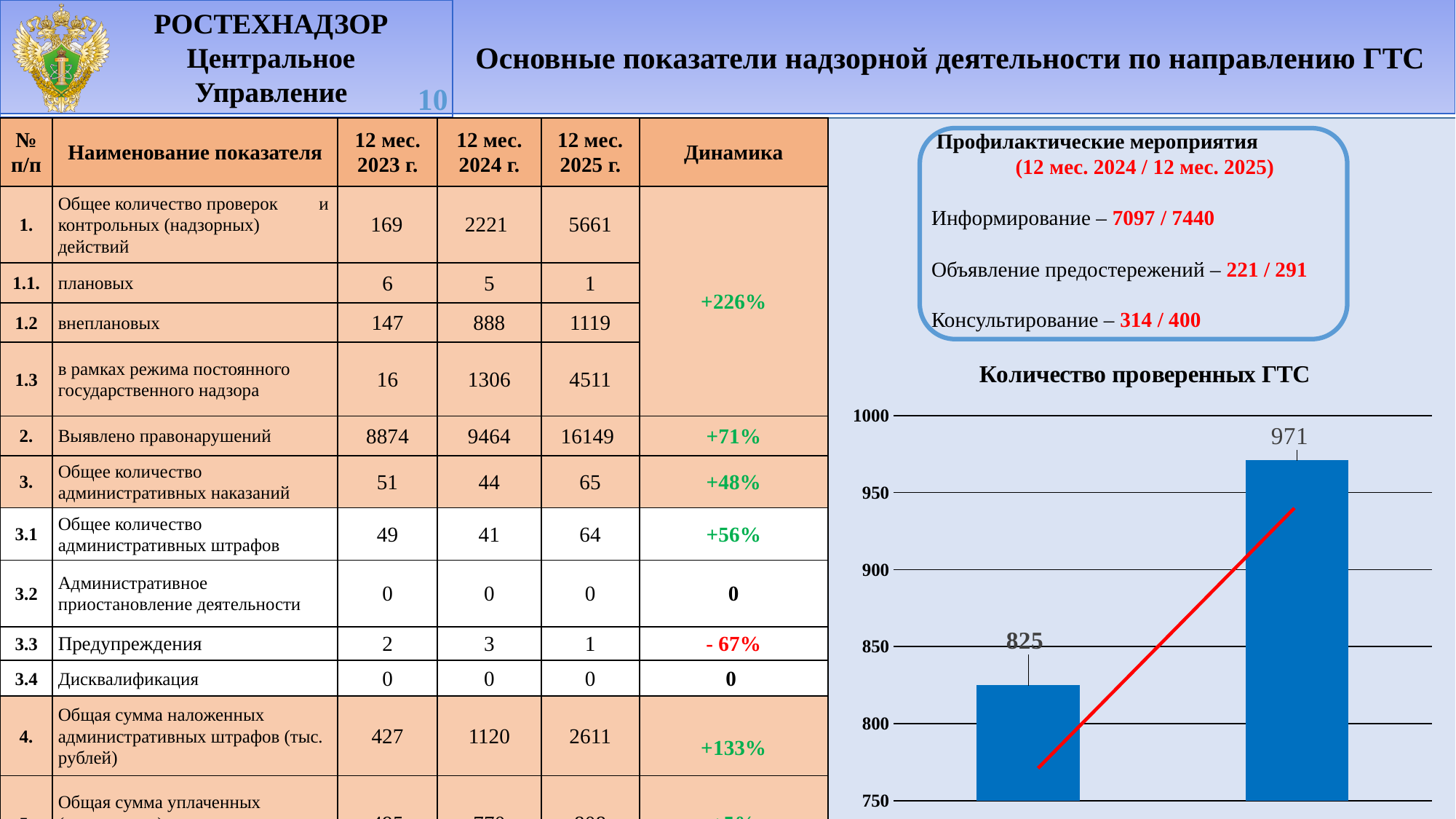
In the 'Количество проверенных ГТС' chart, do the values rise or fall from left to right? rise In the 'Количество проверенных ГТС' chart, what is the value of the left bar? 825 In the 'Количество проверенных ГТС' chart, which bar is the highest? the right bar (971) What type of chart is 'Количество проверенных ГТС'? bar chart What is the highest value shown on the vertical axis of the 'Количество проверенных ГТС' chart? 1000 In the 'Количество проверенных ГТС' chart, which bar is the lowest? the left bar (825) In the 'Количество проверенных ГТС' chart, is the value of the right bar greater or less than 950? greater In the 'Количество проверенных ГТС' chart, what is the difference between the right bar and the left bar? 146 In the 'Количество проверенных ГТС' chart, is the value of the left bar greater or less than 850? less In the 'Количество проверенных ГТС' chart, is the left bar or the right bar larger? the right bar How many bars are plotted in the 'Количество проверенных ГТС' chart? 2 In the 'Количество проверенных ГТС' chart, what is the value of the right bar? 971